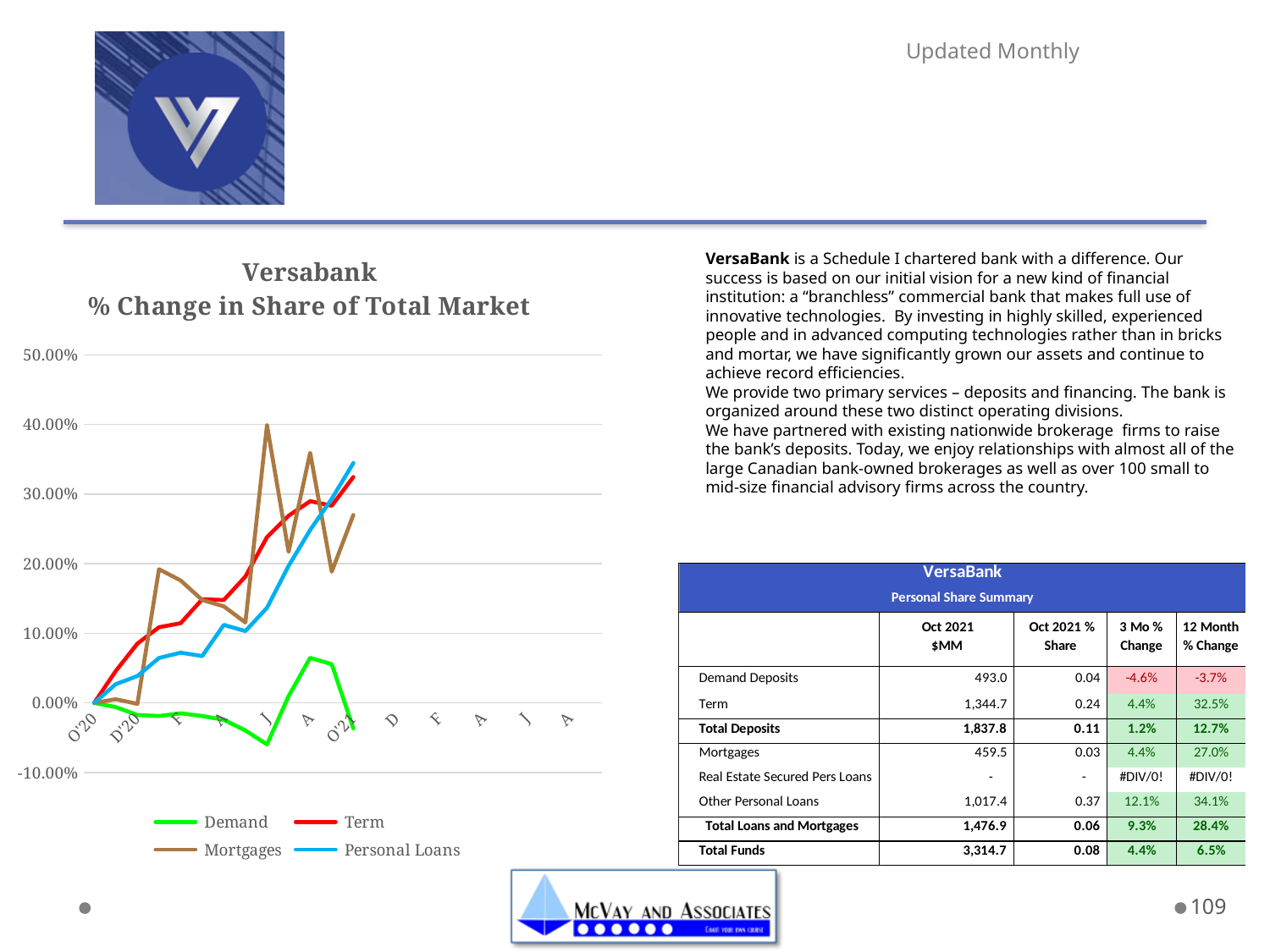
Which series has the lowest value at O'21? Demand At O'21, which is larger, the value for Personal Loans or the value for Demand? Personal Loans How many series does the legend of the chart list? 4 Is the value for Demand at O'21 greater or less than 10.00%? less Does the Term series generally rise or fall from O'20 to O'21? rise What is the highest value shown on the chart's vertical axis? 50.00% Which series are listed in the chart's legend? Demand, Term, Mortgages, Personal Loans What kind of chart is shown on the slide? line chart Is the value for Personal Loans at O'21 greater or less than 30.00%? greater What is the title of the chart? Versabank % Change in Share of Total Market Is the peak value of the Mortgages series greater or less than 30.00%? greater Which series reaches the highest value on the chart? Mortgages